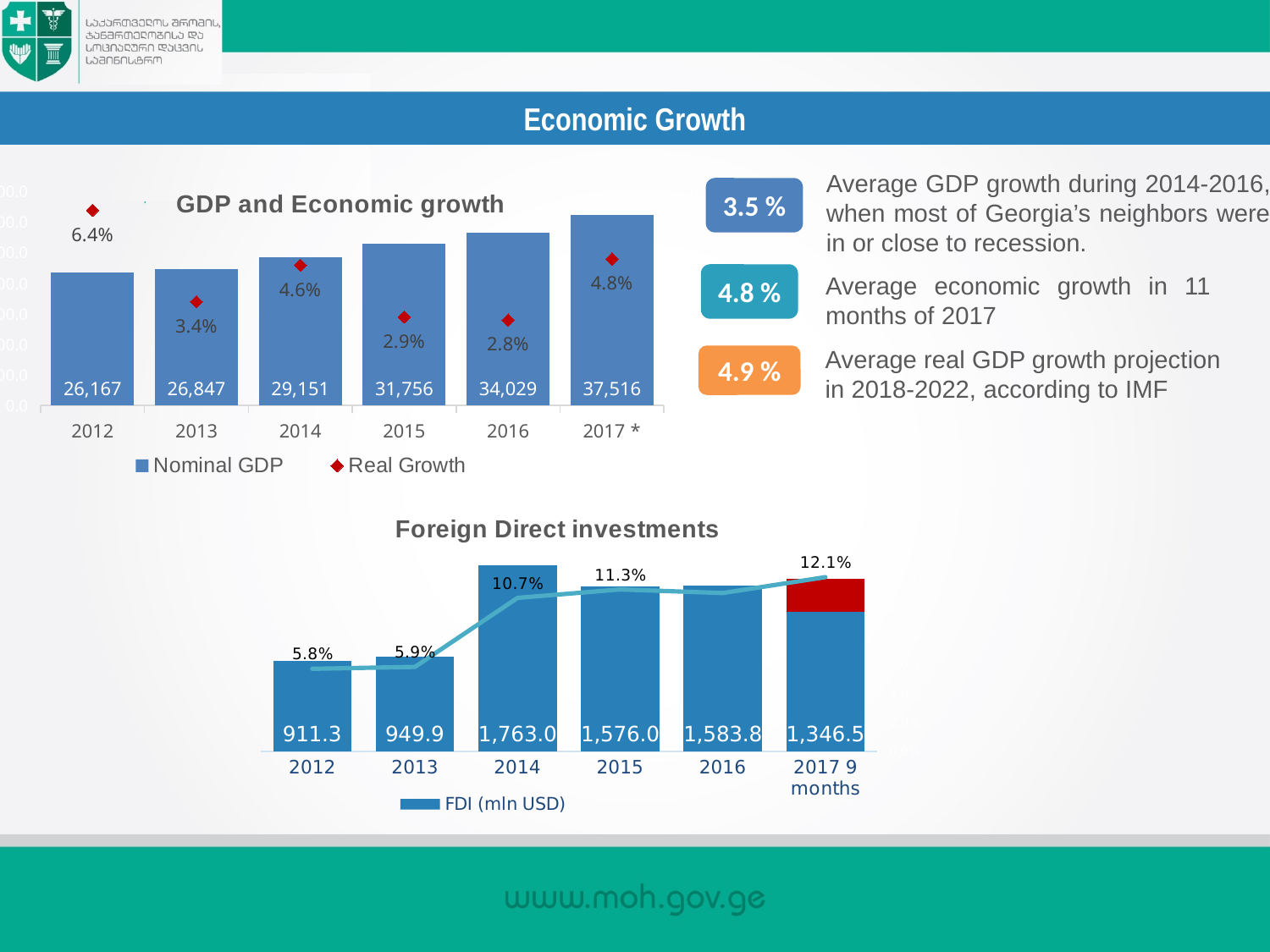
In the 'GDP and Economic growth' chart, do the Nominal GDP values rise or fall from 2012 to 2017? rise In the 'Foreign Direct investments' chart, is the FDI value for 2016 larger than the value for 2015? Yes In the 'Foreign Direct investments' chart, what is the FDI value for 2014? 1,763.0 In the 'Foreign Direct investments' chart, how many categories are shown on the x axis? 6 In the 'GDP and Economic growth' chart, which year has the lowest Real Growth? 2016 In the 'GDP and Economic growth' chart, how many series does the legend list? 2 In the 'GDP and Economic growth' chart, what is the Real Growth value for 2012? 6.4% In the 'GDP and Economic growth' chart, which year has the highest Nominal GDP? 2017 * In the 'Foreign Direct investments' chart, which year has the lowest FDI value? 2012 In the 'GDP and Economic growth' chart, what is the difference in Nominal GDP between 2016 and 2015? 2,273 In the 'GDP and Economic growth' chart, what is the Nominal GDP value for 2014? 29,151 In the 'Foreign Direct investments' chart, what is the percentage label shown above the 2015 bar? 11.3%